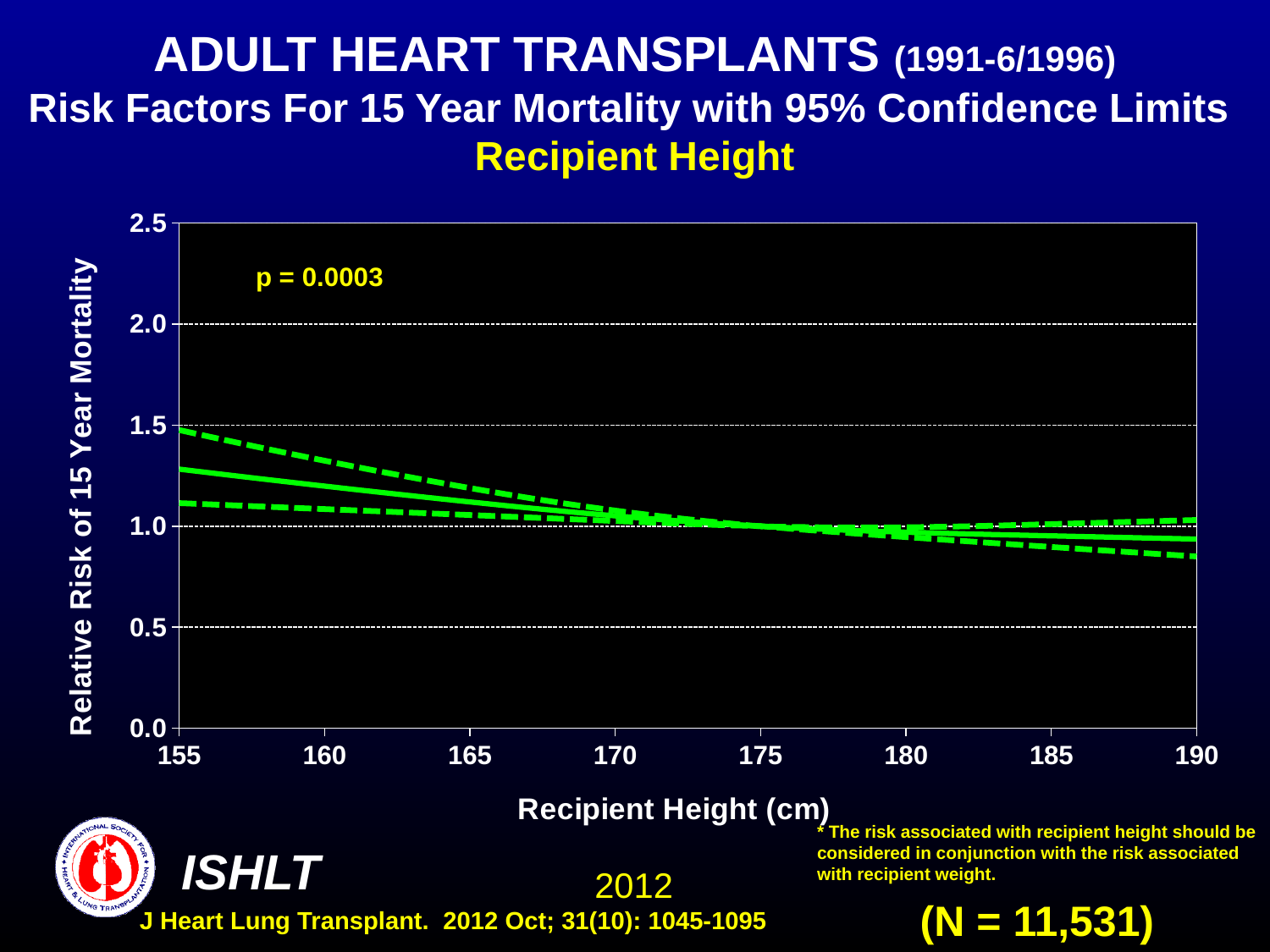
What p-value is printed on the chart? p = 0.0003 What is the label of the x axis? Recipient Height (cm) Is the relative risk (solid line) at a recipient height of 155 cm greater or less than 1.5? less How many lines are plotted on the chart? 3 Is the relative risk (solid line) at a recipient height of 190 cm greater or less than 1.0? less Does the solid relative risk line rise or fall as recipient height increases from 155 cm to 190 cm? fall What kind of chart is shown on the slide? line chart What is the sample size (N) shown on the slide? N = 11,531 Is the relative risk (solid line) at a recipient height of 155 cm greater or less than 1.0? greater What is the label of the y axis? Relative Risk of 15 Year Mortality Which is larger, the relative risk (solid line) at 155 cm or at 190 cm? 155 cm